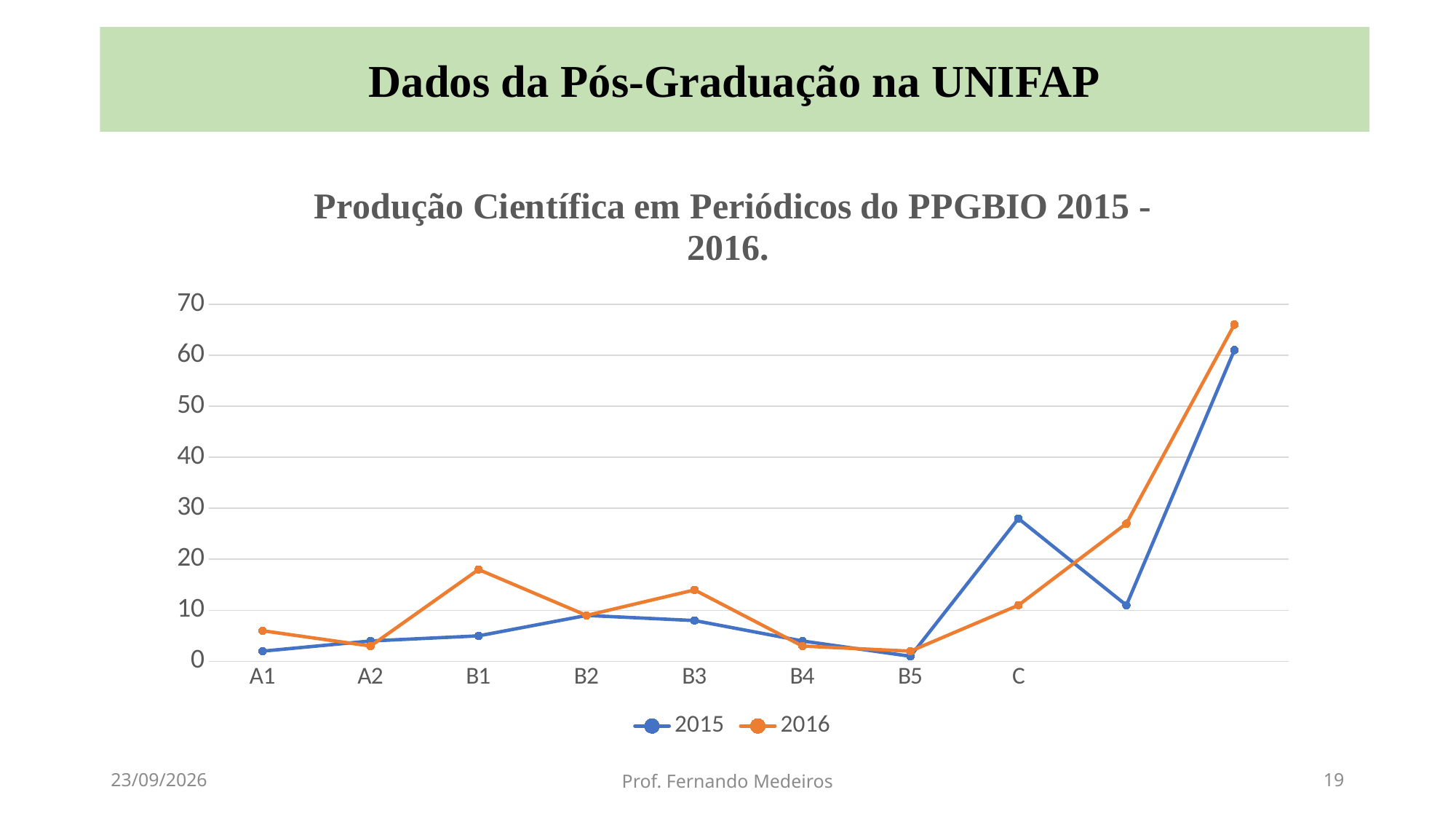
At B1, which series has the higher value, 2015 or 2016? 2016 What kind of chart is shown on the slide? line chart Among the labelled categories A1 to C, which has the highest 2015 value? C At B3, which series has the higher value, 2015 or 2016? 2016 What is the title of the chart? Produção Científica em Periódicos do PPGBIO 2015 - 2016. Is the 2015 value for B5 greater or less than 10? less Is the 2015 value for C greater or less than 20? greater Is the 2016 value for B1 greater or less than 10? greater Which series are listed in the legend? 2015 and 2016 How many series does the legend list? 2 At C, which series has the higher value, 2015 or 2016? 2015